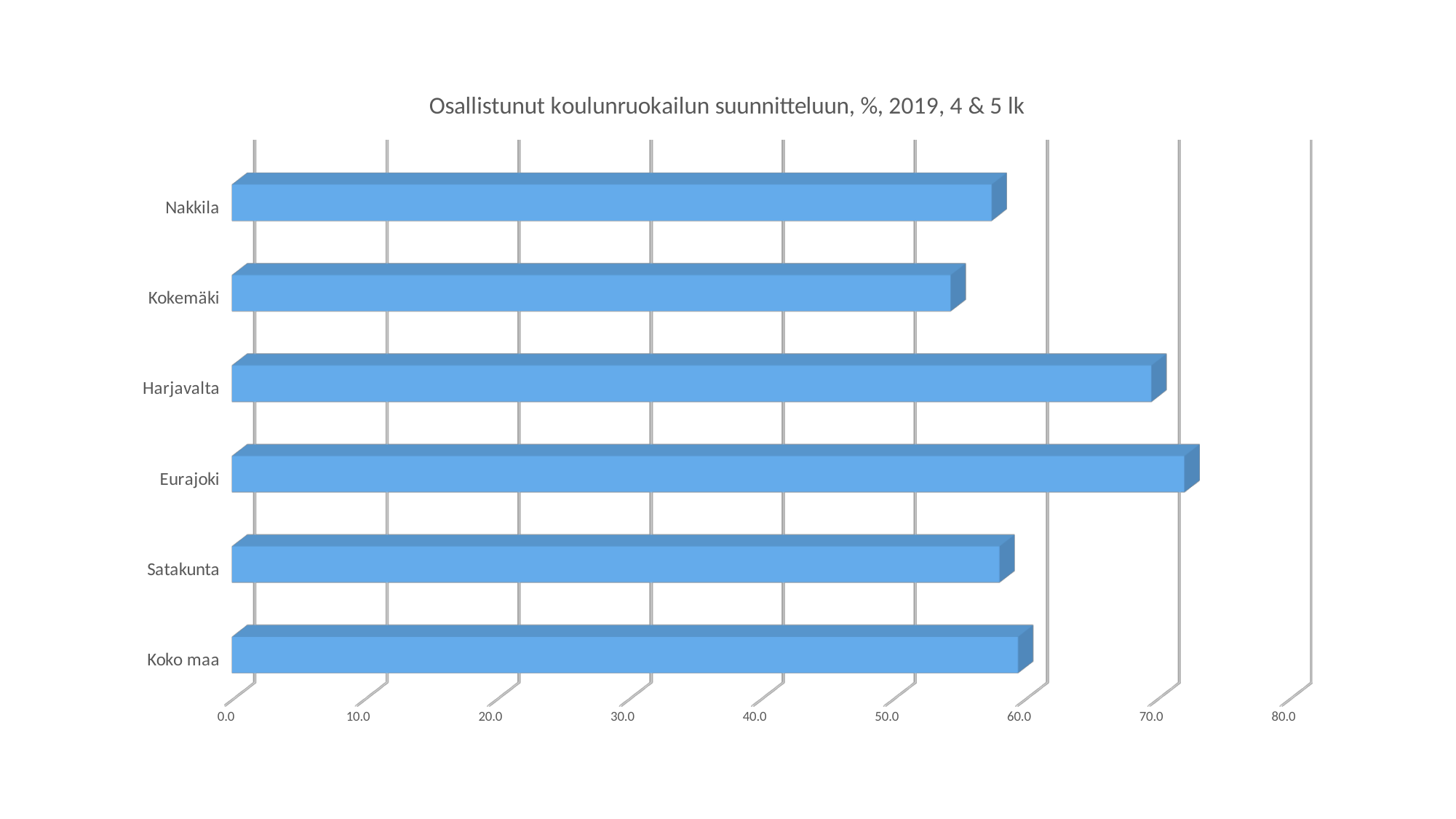
Which is larger, the value for Koko maa or the value for Kokemäki? Koko maa Which category has the highest value? Eurajoki Which is larger, the value for Eurajoki or the value for Nakkila? Eurajoki Is the value for Eurajoki greater or less than 70.0? greater What is the title of the chart? Osallistunut koulunruokailun suunnitteluun, %, 2019, 4 & 5 lk What kind of chart is shown on the slide? bar chart How many categories are plotted in the chart? 6 Which is larger, the value for Harjavalta or the value for Kokemäki? Harjavalta Is the value for Nakkila greater or less than 50.0? greater Which category has the lowest value? Kokemäki Is the value for Harjavalta greater or less than 60.0? greater